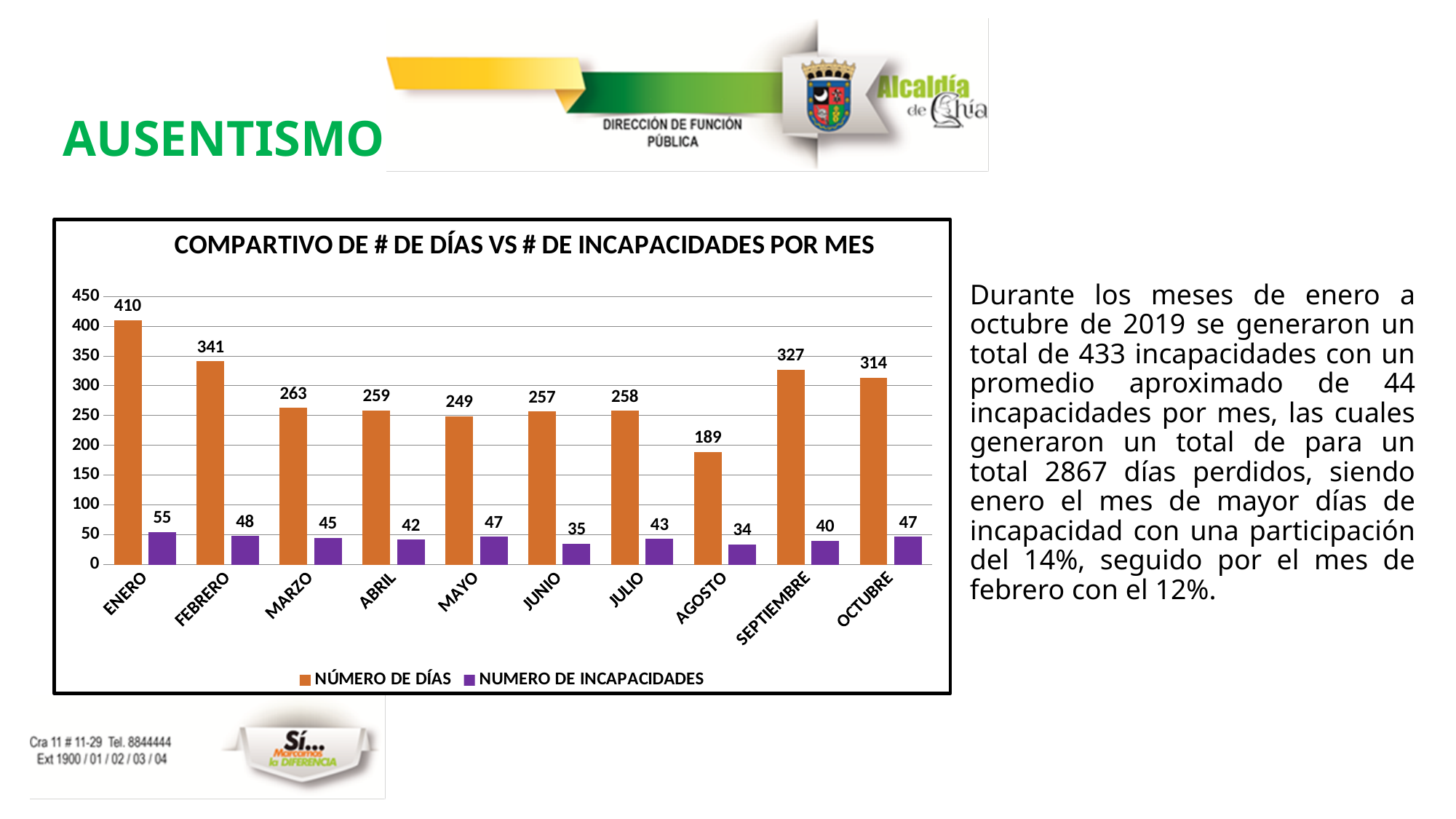
Which month has the highest NÚMERO DE DÍAS? ENERO How many months are shown on the x axis? 10 Which month has the lowest NÚMERO DE DÍAS? AGOSTO What kind of chart is shown? Bar chart What is the NÚMERO DE DÍAS value for ENERO? 410 What is the NÚMERO DE DÍAS value for SEPTIEMBRE? 327 What is the title of the chart? COMPARTIVO DE # DE DÍAS VS # DE INCAPACIDADES POR MES What is the NUMERO DE INCAPACIDADES value for AGOSTO? 34 Which is larger, the NÚMERO DE DÍAS for SEPTIEMBRE or for OCTUBRE? SEPTIEMBRE Which month has the lowest NUMERO DE INCAPACIDADES? AGOSTO What is the difference in NÚMERO DE DÍAS between ENERO and FEBRERO? 69 How many series does the legend list? 2